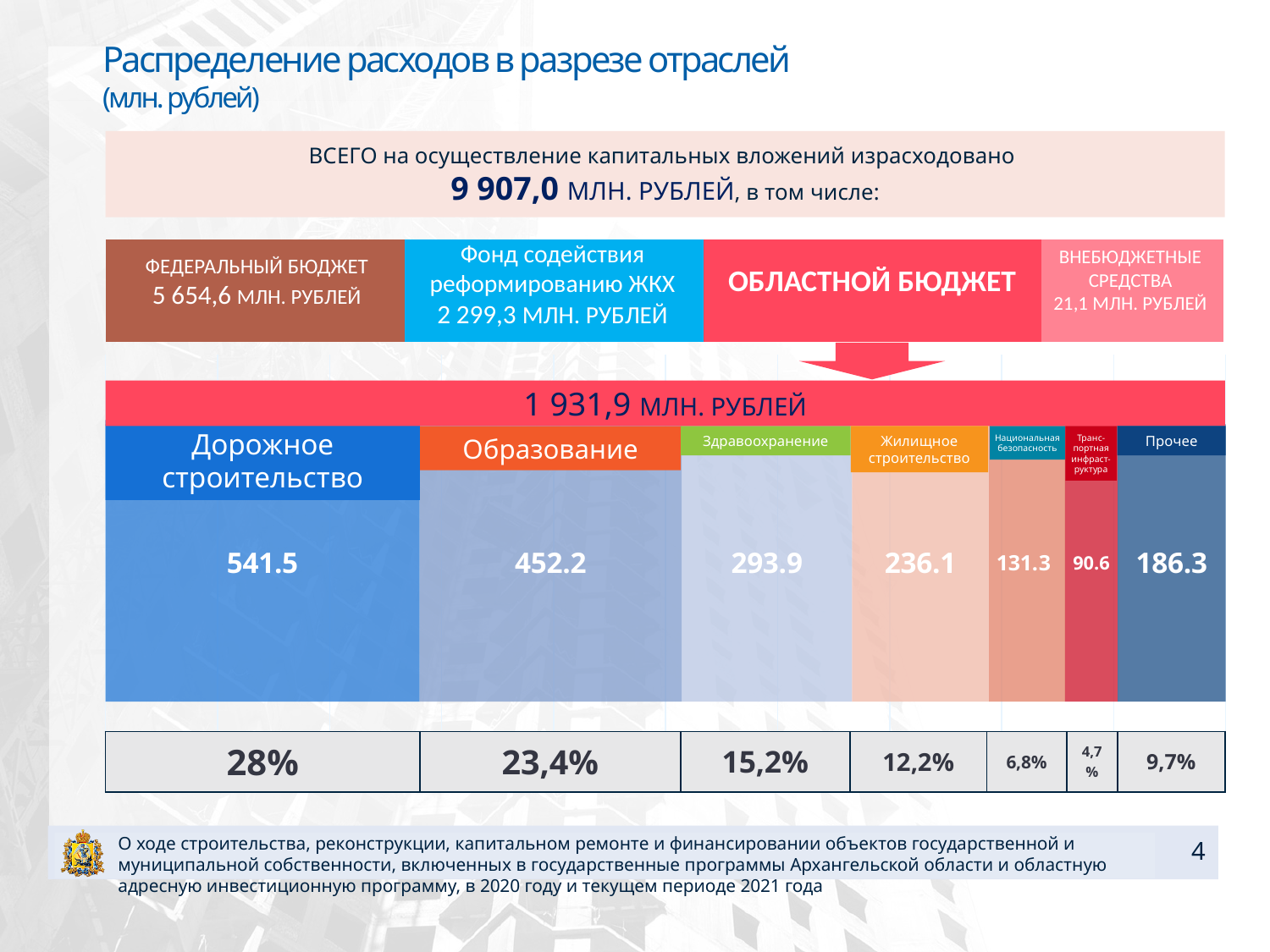
What is the value for Образование in the regional budget breakdown chart? 452.2 How many sectors are shown in the regional budget breakdown chart? 7 What is the value for Здравоохранение in the regional budget breakdown chart? 293.9 Which sector has the lowest value in the regional budget breakdown chart? Транспортная инфраструктура What is the difference between the values for Дорожное строительство and Образование? 89.3 What is the value for Прочее in the regional budget breakdown chart? 186.3 Which is larger, the value for Прочее or the value for Национальная безопасность? Прочее What total amount of the regional budget (ОБЛАСТНОЙ БЮДЖЕТ) is broken down in the chart? 1 931,9 млн. рублей What share of the regional budget does Здравоохранение account for? 15,2% What is the value for Дорожное строительство in the regional budget breakdown chart? 541.5 What is the value for Жилищное строительство in the regional budget breakdown chart? 236.1 Which sector has the highest value in the regional budget breakdown chart? Дорожное строительство